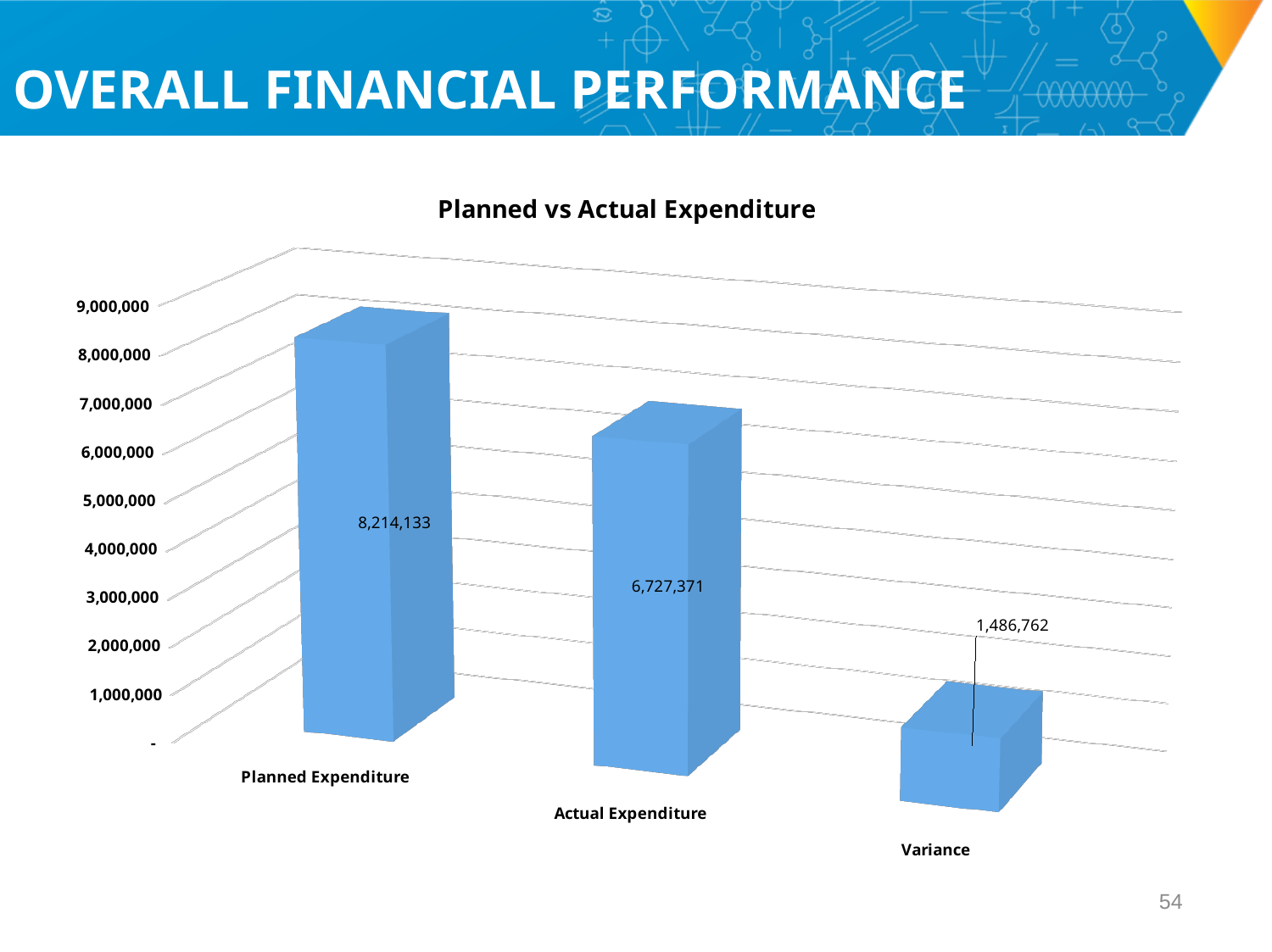
What kind of chart is shown on the slide? Bar chart How many categories are shown on the chart? 3 What is the title of the chart? Planned vs Actual Expenditure Which is larger, Actual Expenditure or Variance? Actual Expenditure What is the value for Planned Expenditure? 8,214,133 Is the value for Actual Expenditure greater or less than 5,000,000? greater What is the value for Actual Expenditure? 6,727,371 Which category has the lowest value? Variance Which category has the highest value? Planned Expenditure Do the values rise or fall from left to right across the categories? Fall What is the value for Variance? 1,486,762 What is the difference between Planned Expenditure and Actual Expenditure? 1,486,762